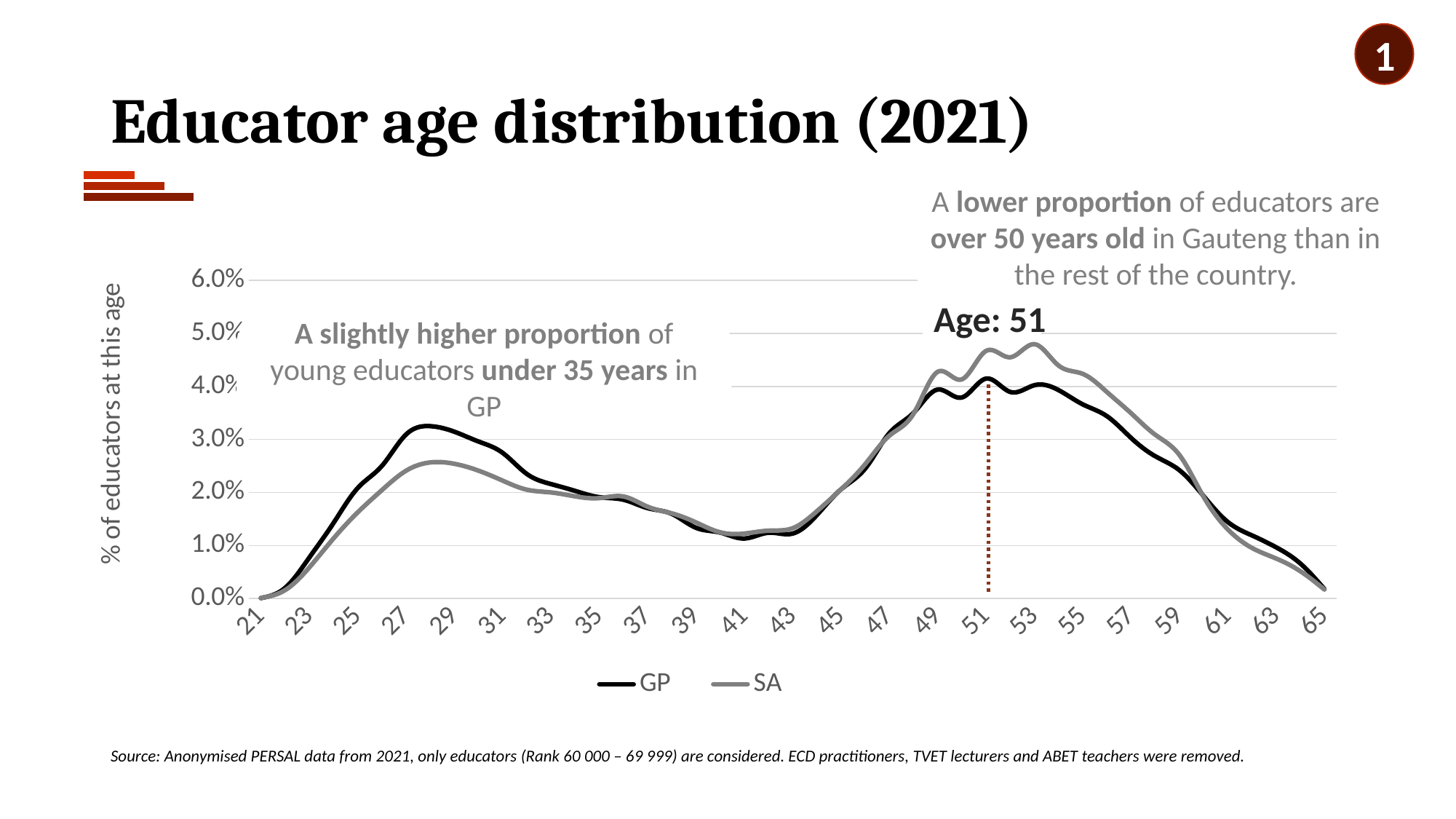
At age 28, which series has the higher value, GP or SA? GP How many age labels are shown on the x axis? 23 Is the SA value at age 28 greater or less than 3.0%? less What are the two series named in the legend? GP and SA What kind of chart is shown on the slide? line chart Is the GP value at age 28 greater or less than 3.0%? greater At age 55, which series has the higher value, GP or SA? SA How many series does the legend list? 2 Does the GP line rise or fall between age 29 and age 41? fall Is the SA value at age 53 greater or less than 4.0%? greater What is the label on the vertical axis? % of educators at this age